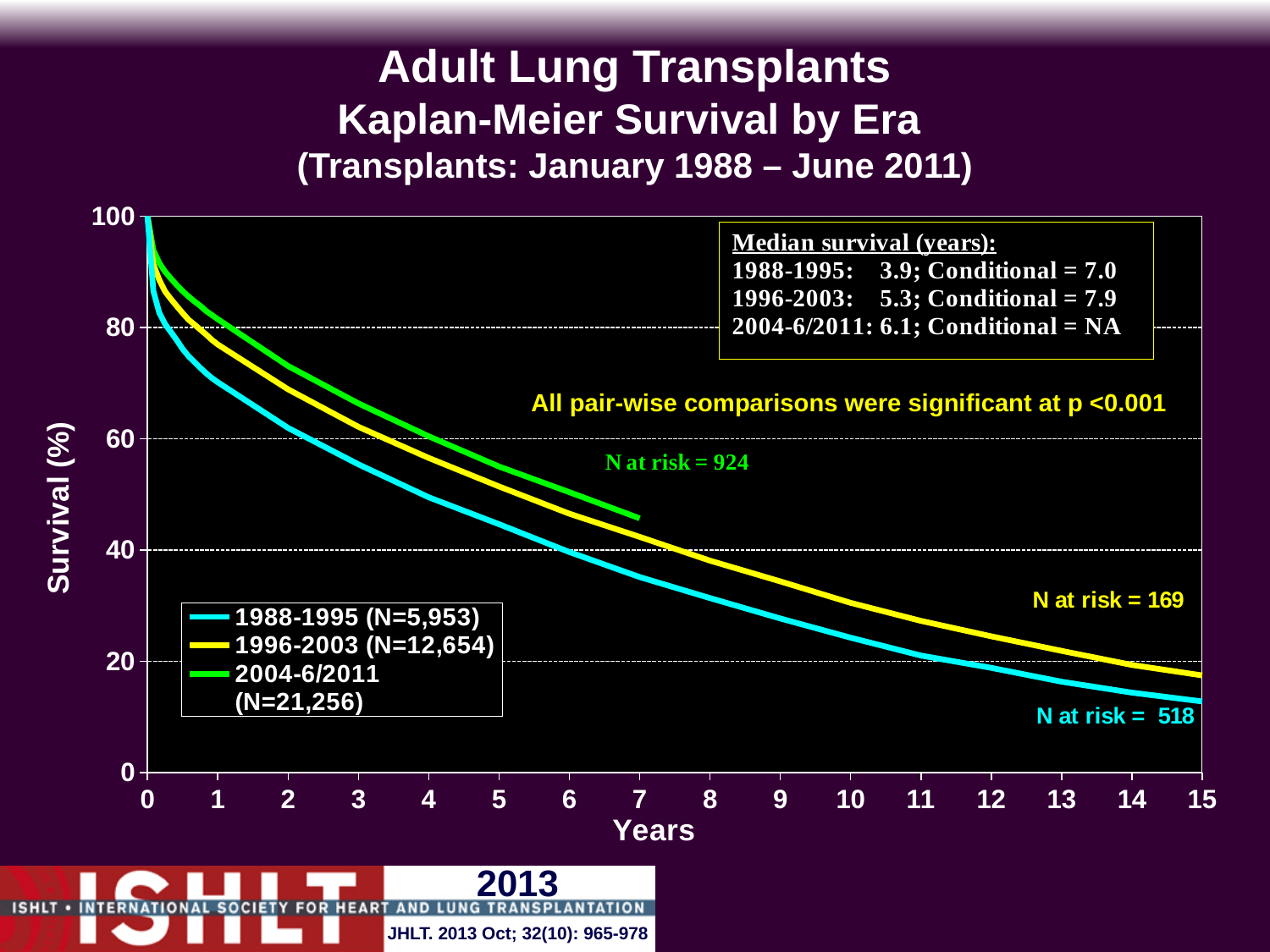
What is the N for the 2004-6/2011 era shown in the legend? 21,256 What is the difference in median survival (years) between the 1996-2003 era and the 1988-1995 era? 1.4 What is the median survival in years for the 1988-1995 era? 3.9 Is the survival for the 1988-1995 era at 5 years greater or less than 60? less Do the survival curves rise or fall as years increase? fall At 5 years, which era has higher survival: 1996-2003 or 1988-1995? 1996-2003 What is the conditional median survival in years for the 1996-2003 era? 7.9 What kind of chart is shown on the slide? line chart What is the label of the x axis? Years Which era has the highest median survival? 2004-6/2011 How many series does the legend list? 3 What is the N at risk shown for the 2004-6/2011 curve? 924